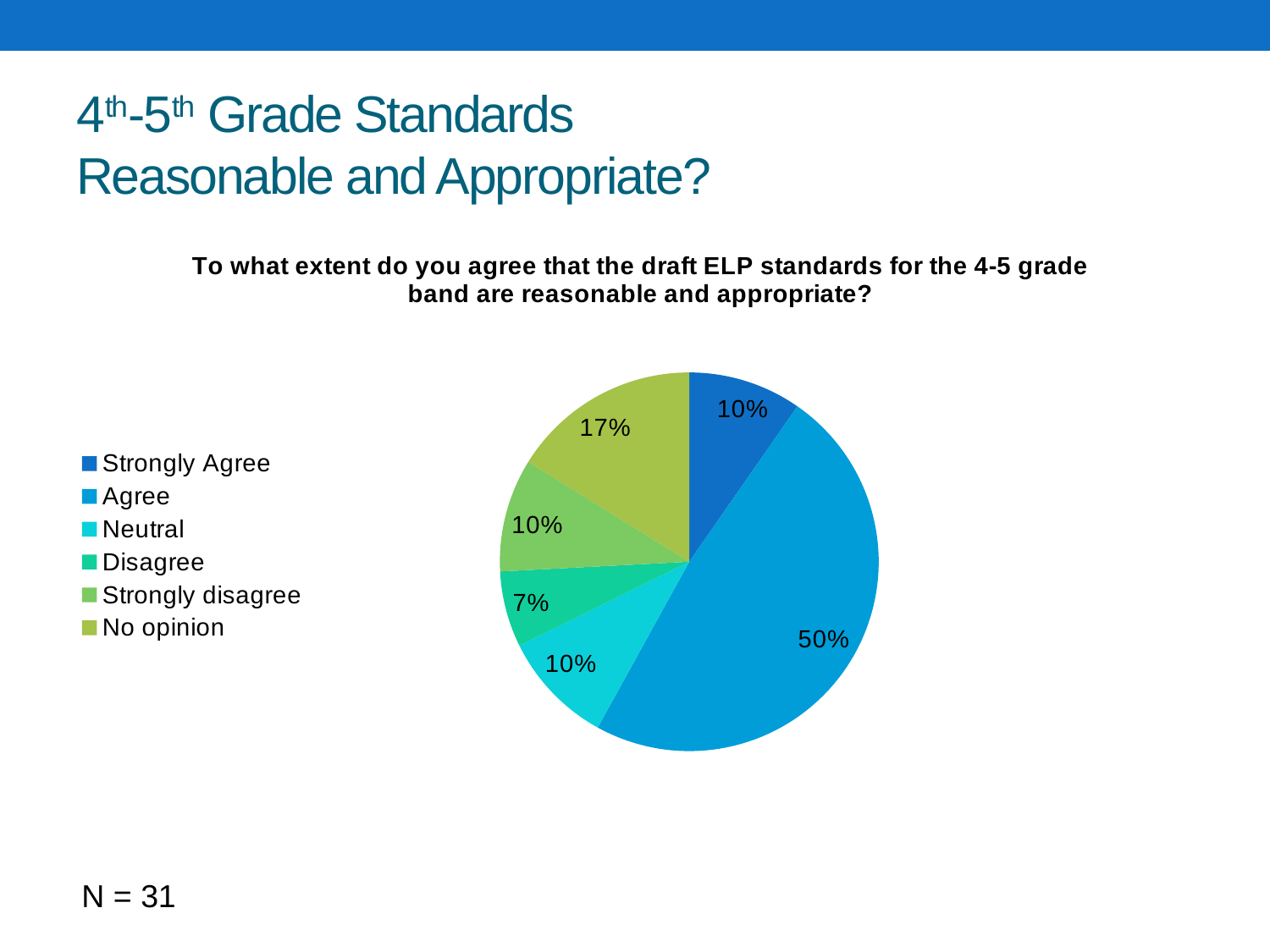
Which is larger, the share for No opinion or the share for Neutral? No opinion What share of the pie does Agree represent? 50% What is the sample size (N) shown on the slide? 31 What percentage of respondents chose No opinion? 17% What is the difference in percentage points between Agree and No opinion? 33 What is the combined share of Strongly Agree and Agree? 60% What percentage of respondents chose Disagree? 7% How many response categories does the legend list? 6 What kind of chart is shown on the slide? Pie chart Which response category has the largest share of the pie? Agree What percentage of respondents chose Strongly Agree? 10% Which response category has the smallest share of the pie? Disagree